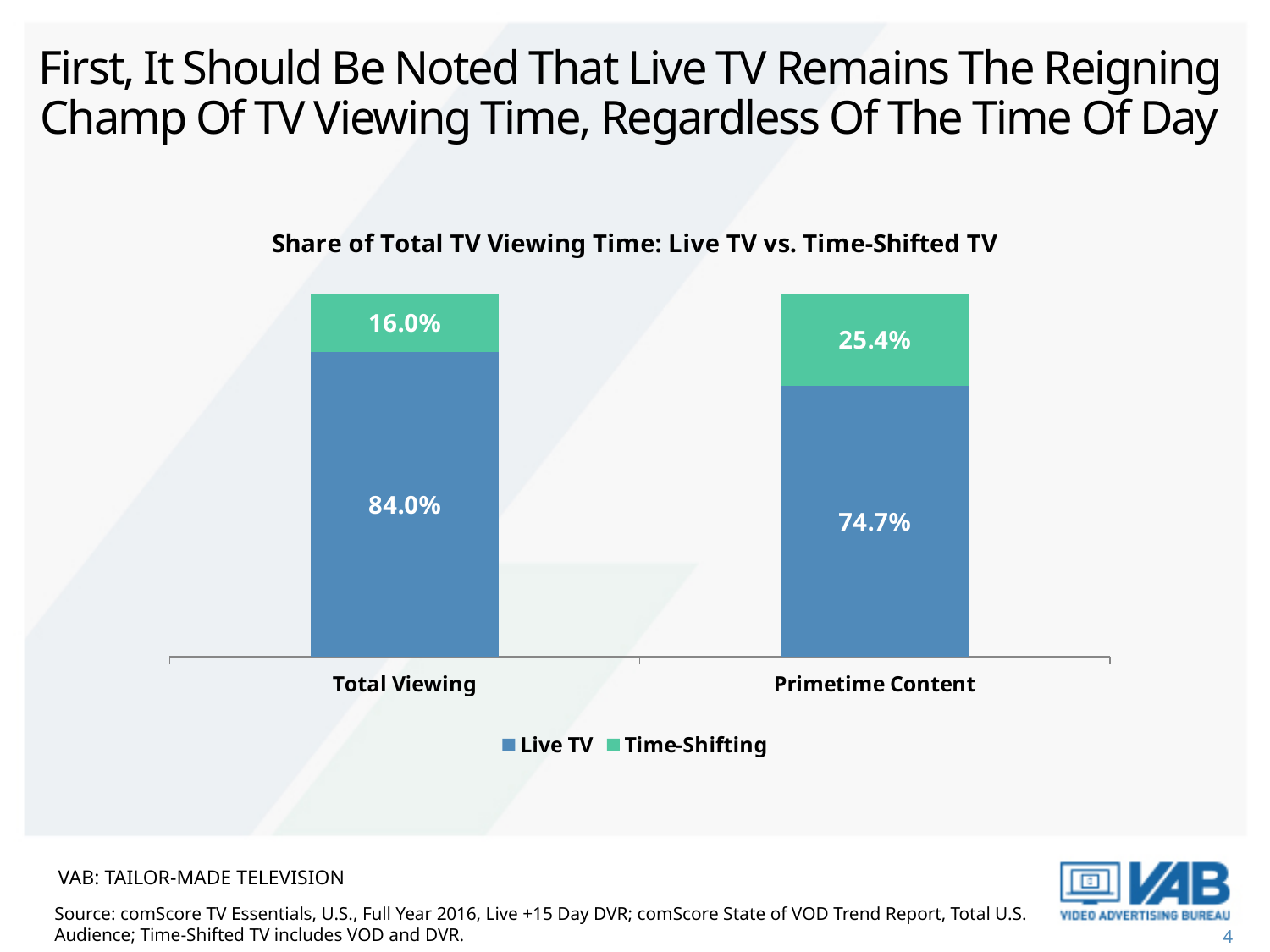
How many series does the legend list? 2 What is the Live TV share for Total Viewing? 84.0% What is the difference between the Time-Shifting shares for Primetime Content and Total Viewing? 9.4 percentage points What is the Live TV share for Primetime Content? 74.7% How many categories are shown on the x axis? 2 What is the difference between the Live TV shares for Total Viewing and Primetime Content? 9.3 percentage points What is the Time-Shifting share for Total Viewing? 16.0% Which category has the highest Time-Shifting share? Primetime Content What kind of chart is shown on the slide? Stacked bar chart What is the total of the stacked bar for Total Viewing? 100.0% Which category has the higher Live TV share, Total Viewing or Primetime Content? Total Viewing What is the Time-Shifting share for Primetime Content? 25.4%